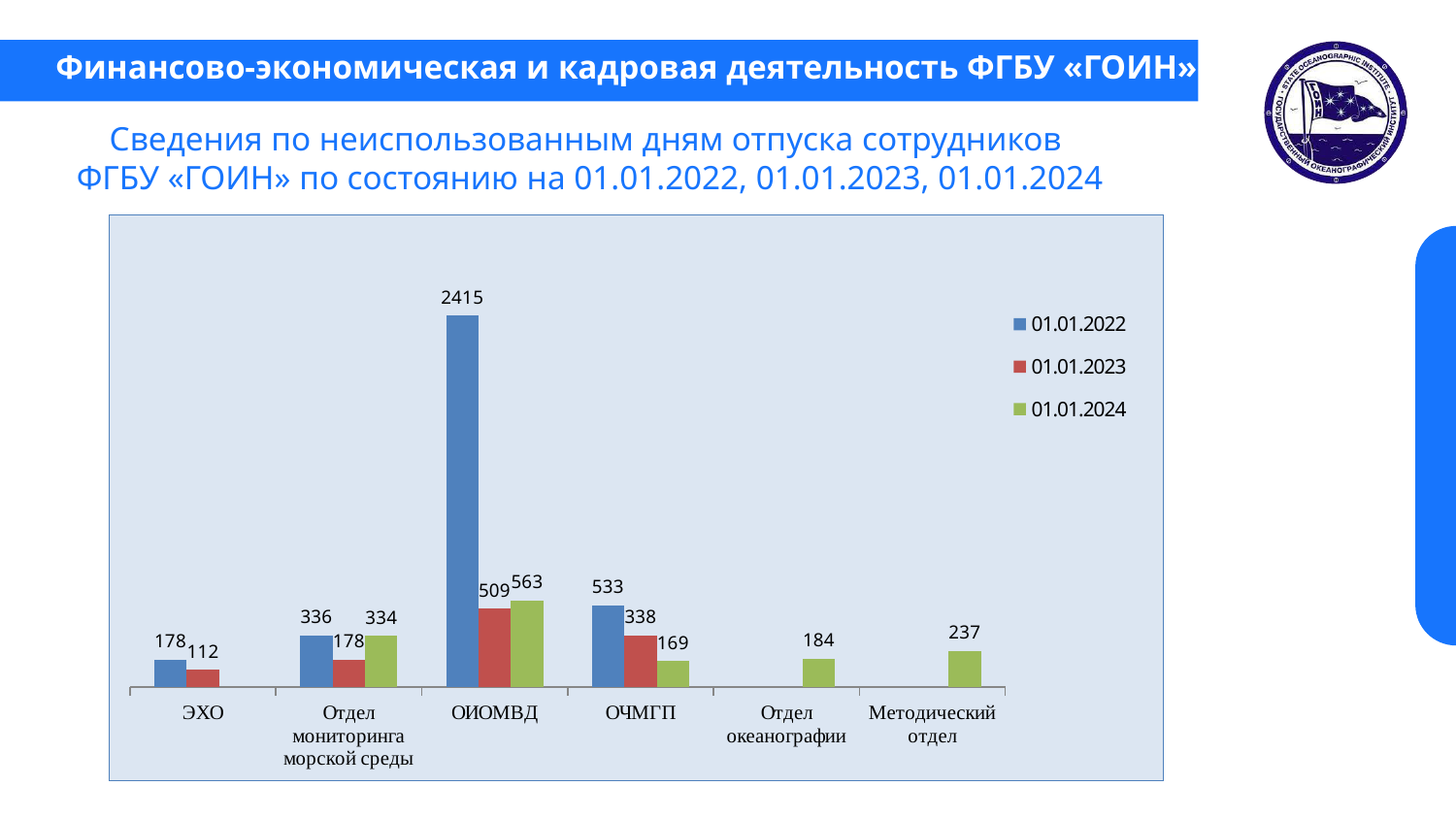
How many categories are shown on the x axis? 6 Which is larger for Отдел мониторинга морской среды: the 01.01.2022 value or the 01.01.2024 value? 01.01.2022 What is the value for ОЧМГП for 01.01.2023? 338 What is the difference between the 01.01.2022 and 01.01.2023 values for ОИОМВД? 1906 How many series does the legend list? 3 Which colour represents the 01.01.2024 series in the legend? green What type of chart is shown on the slide? bar chart What is the value for ОИОМВД for 01.01.2022? 2415 Which category has the highest value for 01.01.2022? ОИОМВД What is the value for ЭХО for 01.01.2023? 112 What is the value for Методический отдел for 01.01.2024? 237 Which category has the lowest value for 01.01.2024? ОЧМГП